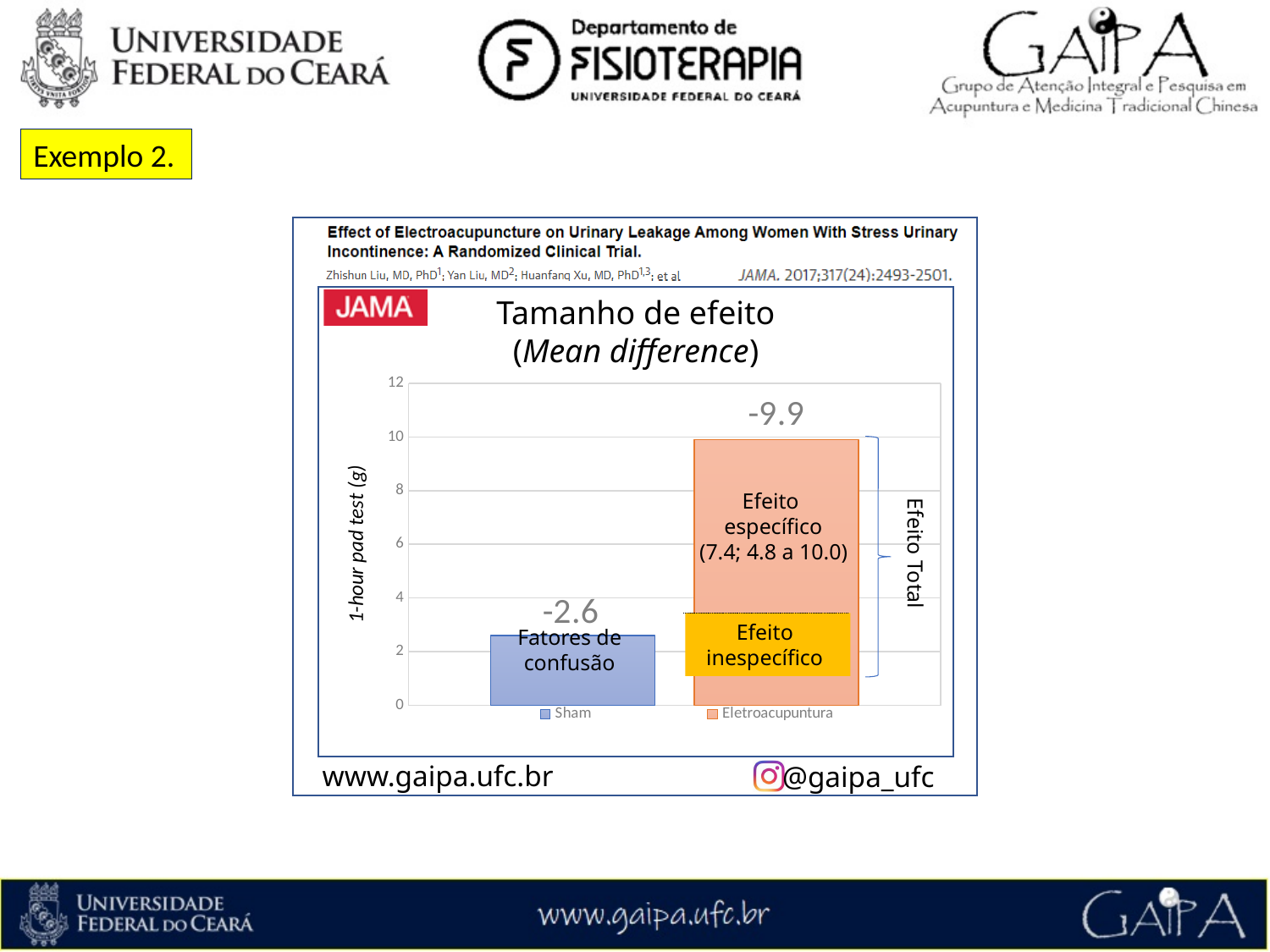
What kind of chart is shown on the slide? bar chart Is the height of the Eletroacupuntura bar greater or less than 8 on the y axis? greater What is the value labelled on the Eletroacupuntura bar? -9.9 Is the height of the Sham bar greater or less than 4 on the y axis? less How many entries does the chart legend list? 2 Which bar is taller, Sham or Eletroacupuntura? Eletroacupuntura Which bar is the shortest in the chart? Sham What is the value labelled on the Sham bar? -2.6 Which bar is the tallest in the chart? Eletroacupuntura How many bars are plotted in the chart? 2 What is the label of the vertical axis of the chart? 1-hour pad test (g) What is the title of the chart? Tamanho de efeito (Mean difference)